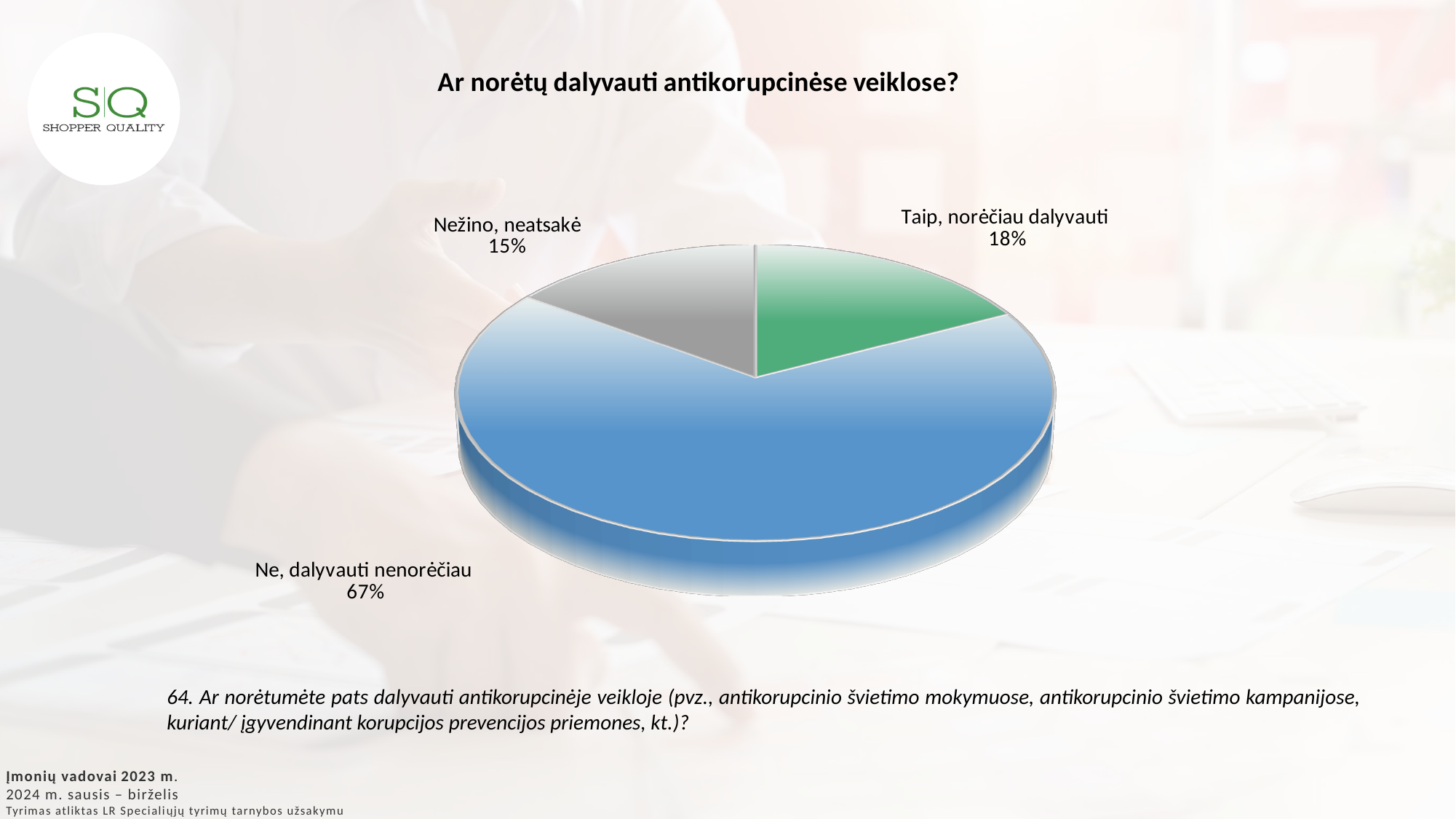
What colour is the slice for "Taip, norėčiau dalyvauti"? Green What share of respondents answered "Taip, norėčiau dalyvauti"? 18% What is the title of the chart? Ar norėtų dalyvauti antikorupcinėse veiklose? What share of respondents answered "Ne, dalyvauti nenorėčiau"? 67% What is the combined share of "Taip, norėčiau dalyvauti" and "Nežino, neatsakė"? 33% What type of chart is shown on the slide? Pie chart Which answer has the largest share of the pie? Ne, dalyvauti nenorėčiau How many slices does the pie chart have? 3 Which is larger: the share for "Taip, norėčiau dalyvauti" or for "Nežino, neatsakė"? Taip, norėčiau dalyvauti Which answer has the smallest share of the pie? Nežino, neatsakė What share of respondents answered "Nežino, neatsakė"? 15% What is the difference in percentage points between "Ne, dalyvauti nenorėčiau" and "Taip, norėčiau dalyvauti"? 49 percentage points